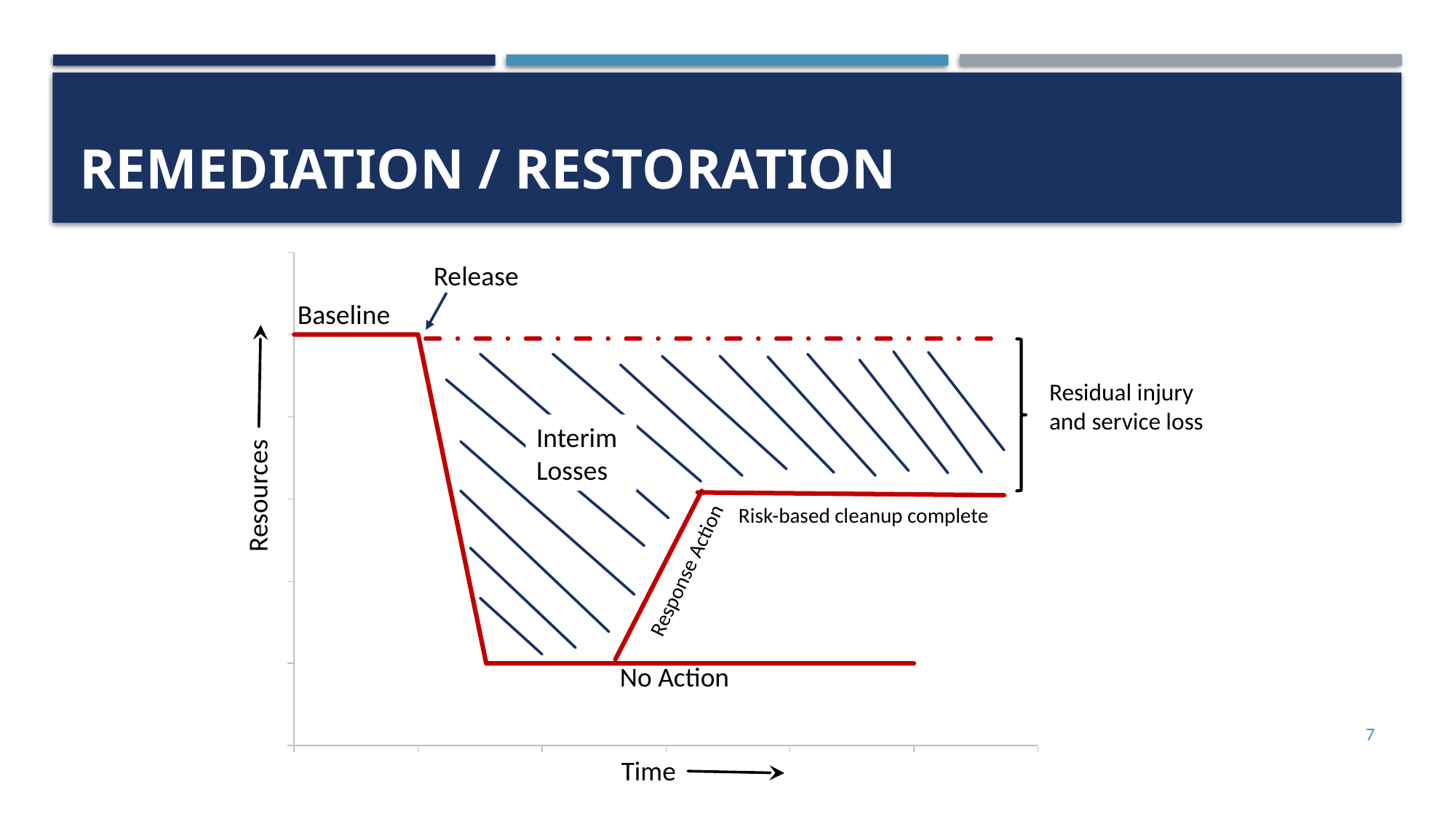
Which plotted level is the lowest on the chart? No Action Along the Response Action segment, do resources rise or fall over time? Rise Which plotted level is the highest on the chart? Baseline Which level is higher: the Baseline or the Risk-based cleanup complete line? Baseline What kind of chart is shown on the slide? Line chart Does the Risk-based cleanup complete line return to the Baseline level? No What does the horizontal axis of the chart represent? Time Immediately after the point labelled Release, do resources rise or fall? Fall Does the No Action line rise, fall, or stay flat over time after the drop? Stay flat What does the vertical axis of the chart represent? Resources Which level is higher: the Risk-based cleanup complete line or the No Action line? Risk-based cleanup complete